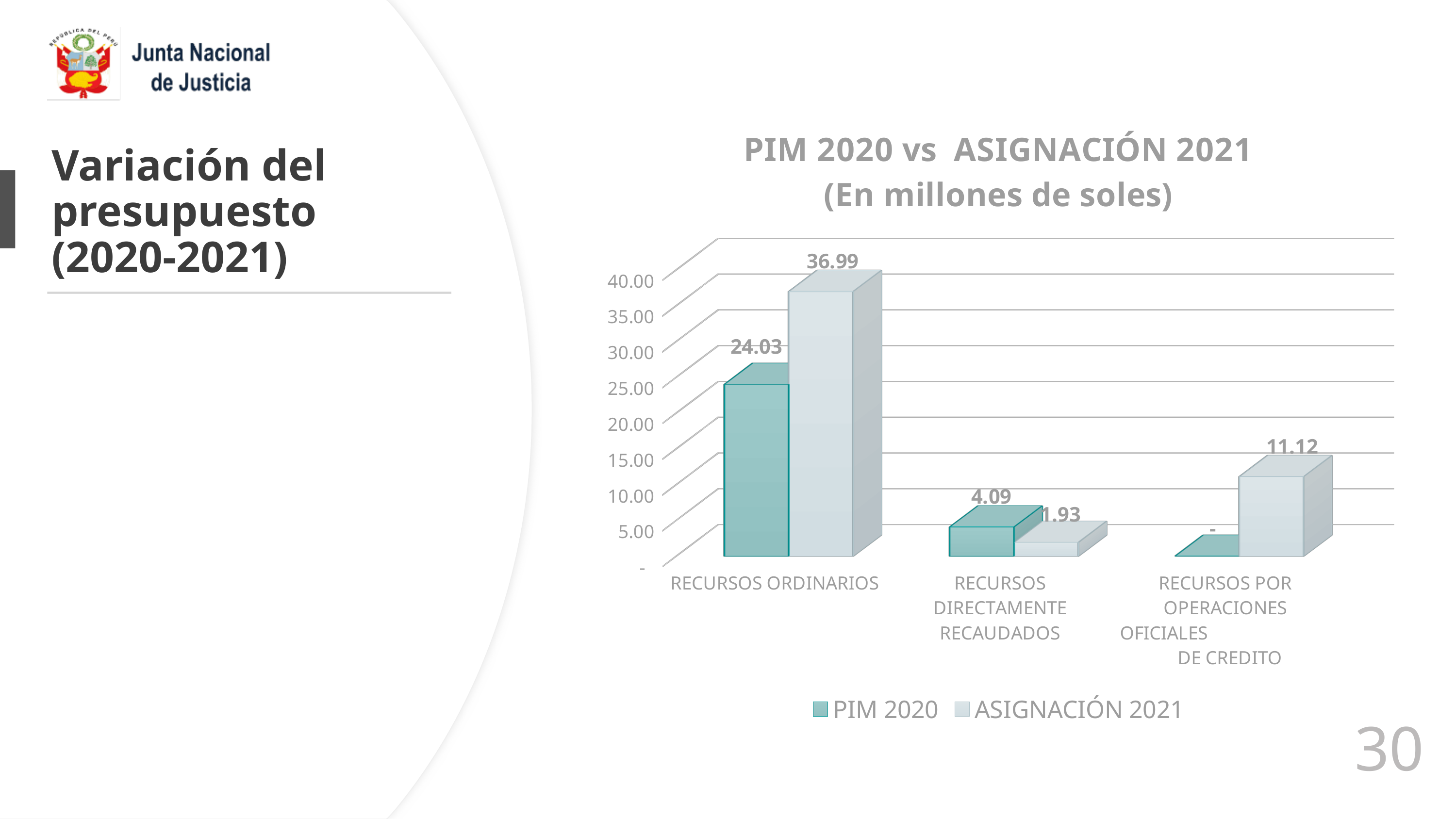
What is the ASIGNACIÓN 2021 value for RECURSOS ORDINARIOS? 36.99 Which category has the highest ASIGNACIÓN 2021 value? RECURSOS ORDINARIOS For RECURSOS DIRECTAMENTE RECAUDADOS, which is larger: PIM 2020 or ASIGNACIÓN 2021? PIM 2020 What is the PIM 2020 value for RECURSOS ORDINARIOS? 24.03 What is the PIM 2020 value for RECURSOS DIRECTAMENTE RECAUDADOS? 4.09 What is the difference between the ASIGNACIÓN 2021 and PIM 2020 values for RECURSOS ORDINARIOS? 12.96 What is the ASIGNACIÓN 2021 value for RECURSOS POR OPERACIONES OFICIALES DE CREDITO? 11.12 Which category has the lowest ASIGNACIÓN 2021 value? RECURSOS DIRECTAMENTE RECAUDADOS What kind of chart is shown on the slide? Bar chart How many categories are shown on the x axis? 3 How many series does the legend list? 2 What is the ASIGNACIÓN 2021 value for RECURSOS DIRECTAMENTE RECAUDADOS? 1.93